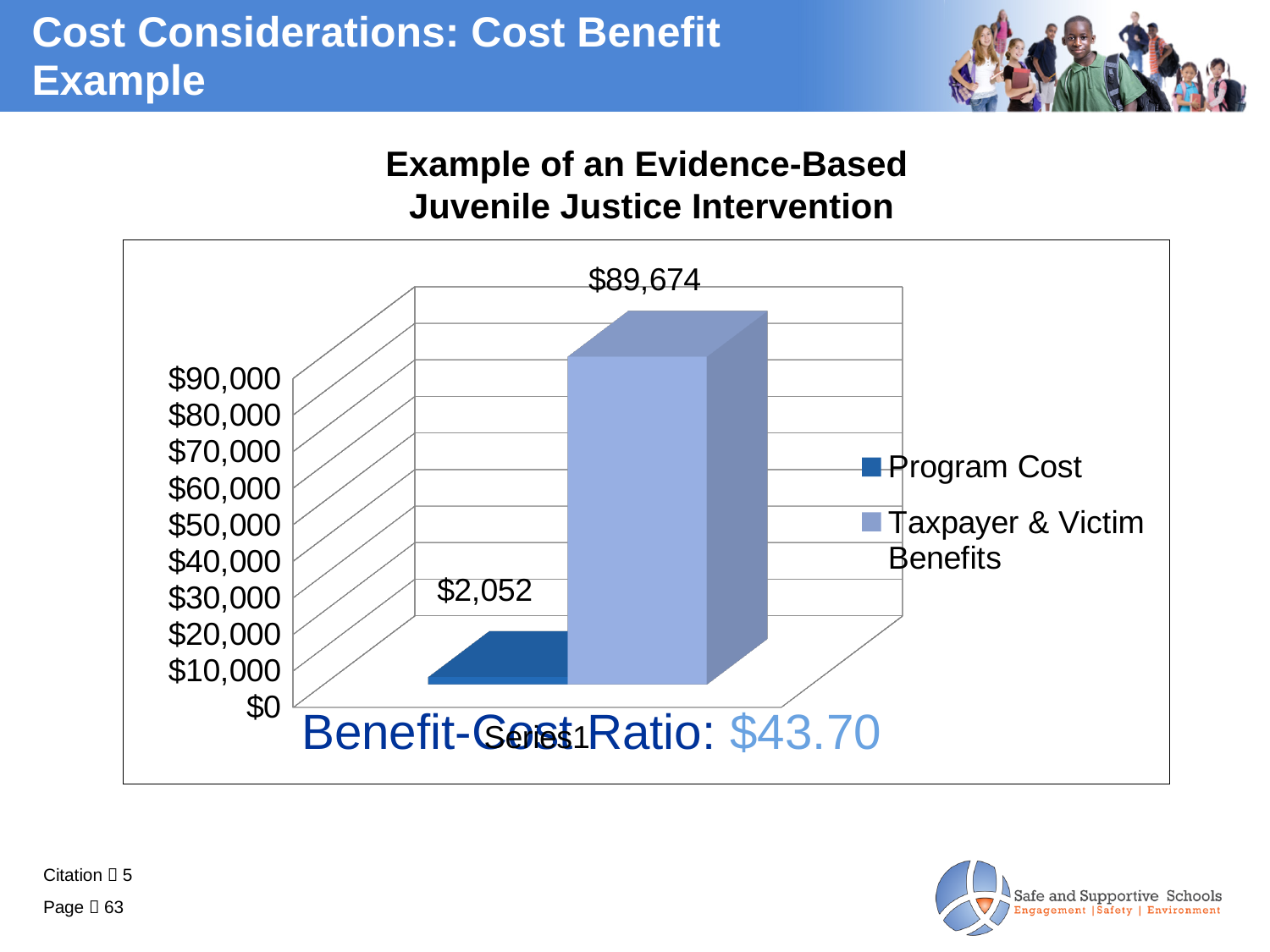
What is the title of the chart? Example of an Evidence-Based Juvenile Justice Intervention What is the difference between the Taxpayer & Victim Benefits value and the Program Cost value? $87,622 What is the highest value labelled on the vertical axis? $90,000 How many series does the legend list? 2 Is the value for Taxpayer & Victim Benefits greater or less than $80,000? greater Which series has the higher value, Program Cost or Taxpayer & Victim Benefits? Taxpayer & Victim Benefits What kind of chart is shown on the slide? bar chart What is the value of the Program Cost bar? $2,052 What Benefit-Cost Ratio is printed on the chart? $43.70 What is the value of the Taxpayer & Victim Benefits bar? $89,674 Which series has the lowest value on the chart? Program Cost Is the value for Program Cost greater or less than $10,000? less